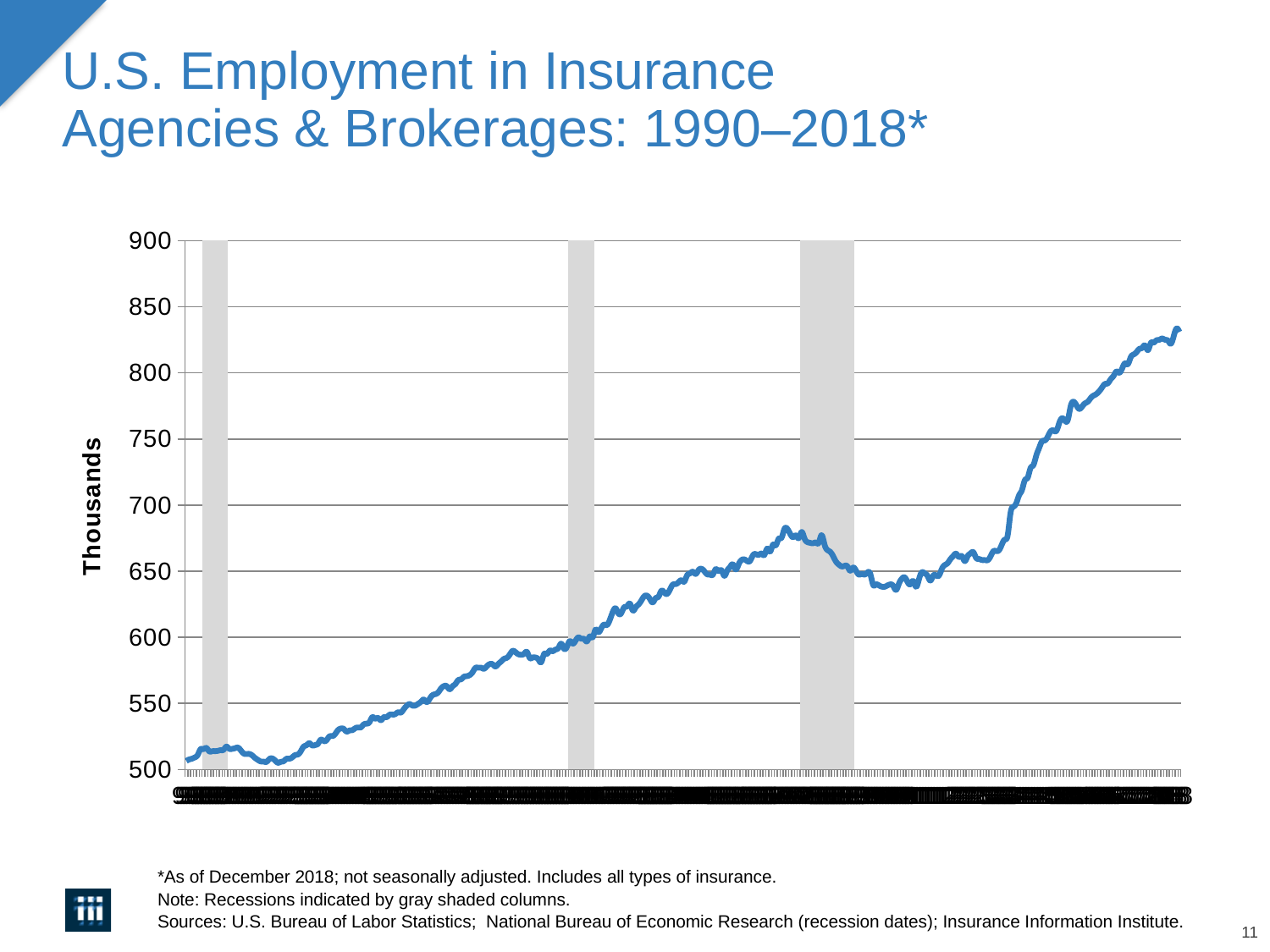
Overall, does the line rise or fall from the left end of the chart to the right end? rise Is the value at the leftmost start of the line greater or less than 550? less What is the highest value shown on the vertical axis of the chart? 900 Is the value at the rightmost end of the line greater or less than the value at the leftmost start of the line? greater How many gray shaded recession columns are shown on the chart? 3 Is the value at the rightmost end of the line greater or less than 800? greater Does the line rise or fall during the third gray shaded column? fall What kind of chart is shown on the slide? line chart Is the lowest point of the line after the third gray shaded column greater or less than 600? greater What is the title of the chart on the slide? U.S. Employment in Insurance Agencies & Brokerages: 1990–2018* What is the label on the vertical axis of the chart? Thousands